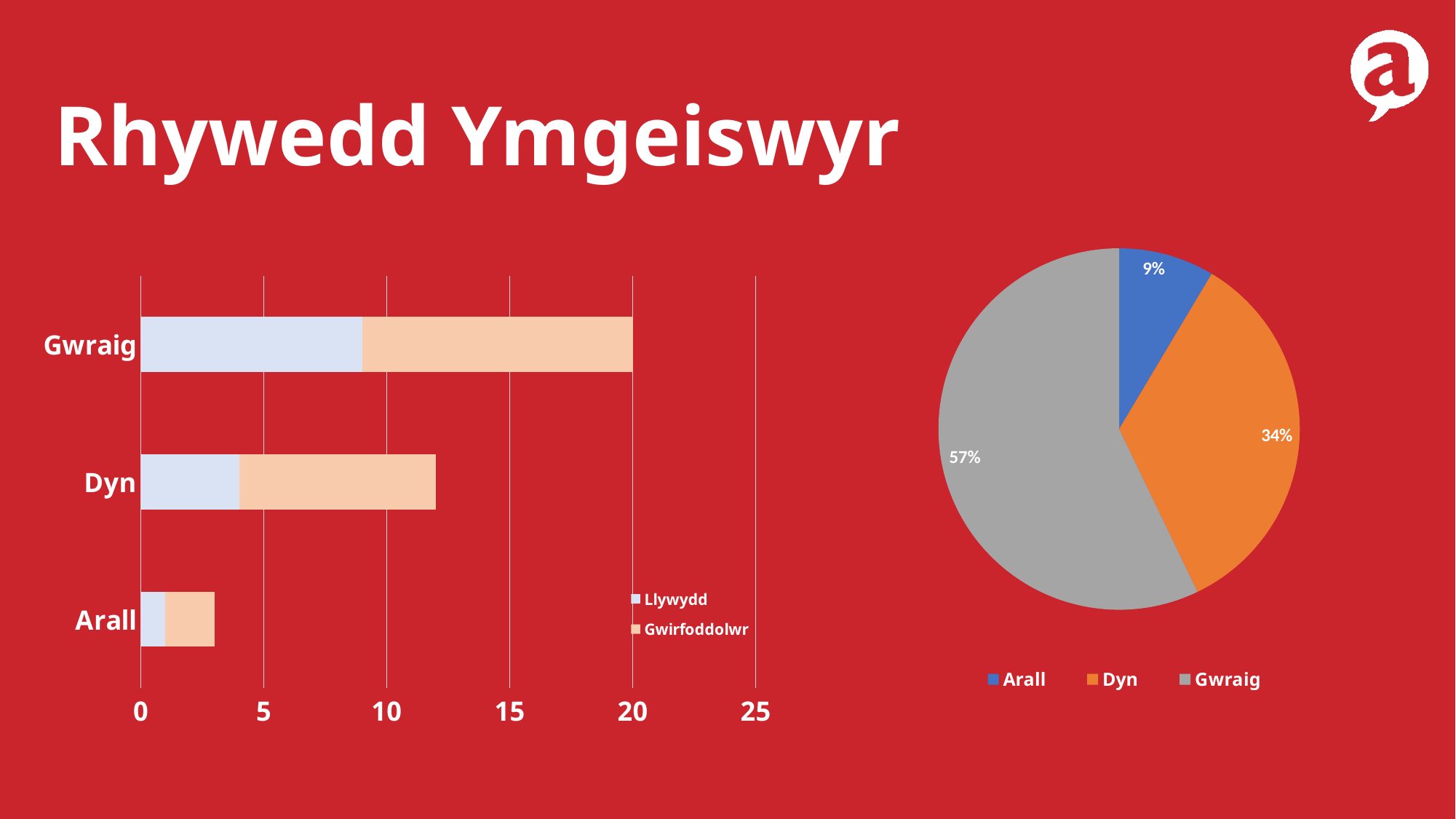
In the bar chart on the left, which category has the longest total bar? Gwraig In the pie chart on the right, what percentage is shown for Gwraig? 57% In the bar chart on the left, how many series does the legend list? 2 In the pie chart on the right, what is the difference between the Gwraig and Dyn percentages? 23% In the bar chart on the left, is the total value for Dyn greater or less than 10? greater In the bar chart on the left, is the total value for Arall greater or less than 5? less In the bar chart on the left, how many categories are shown? 3 In the bar chart on the left, which category has the shortest total bar? Arall In the pie chart on the right, which is larger, Dyn or Arall? Dyn In the pie chart on the right, what percentage is shown for Arall? 9% What kind of chart is the chart on the right of the slide? pie chart What kind of chart is the chart on the left of the slide? bar chart